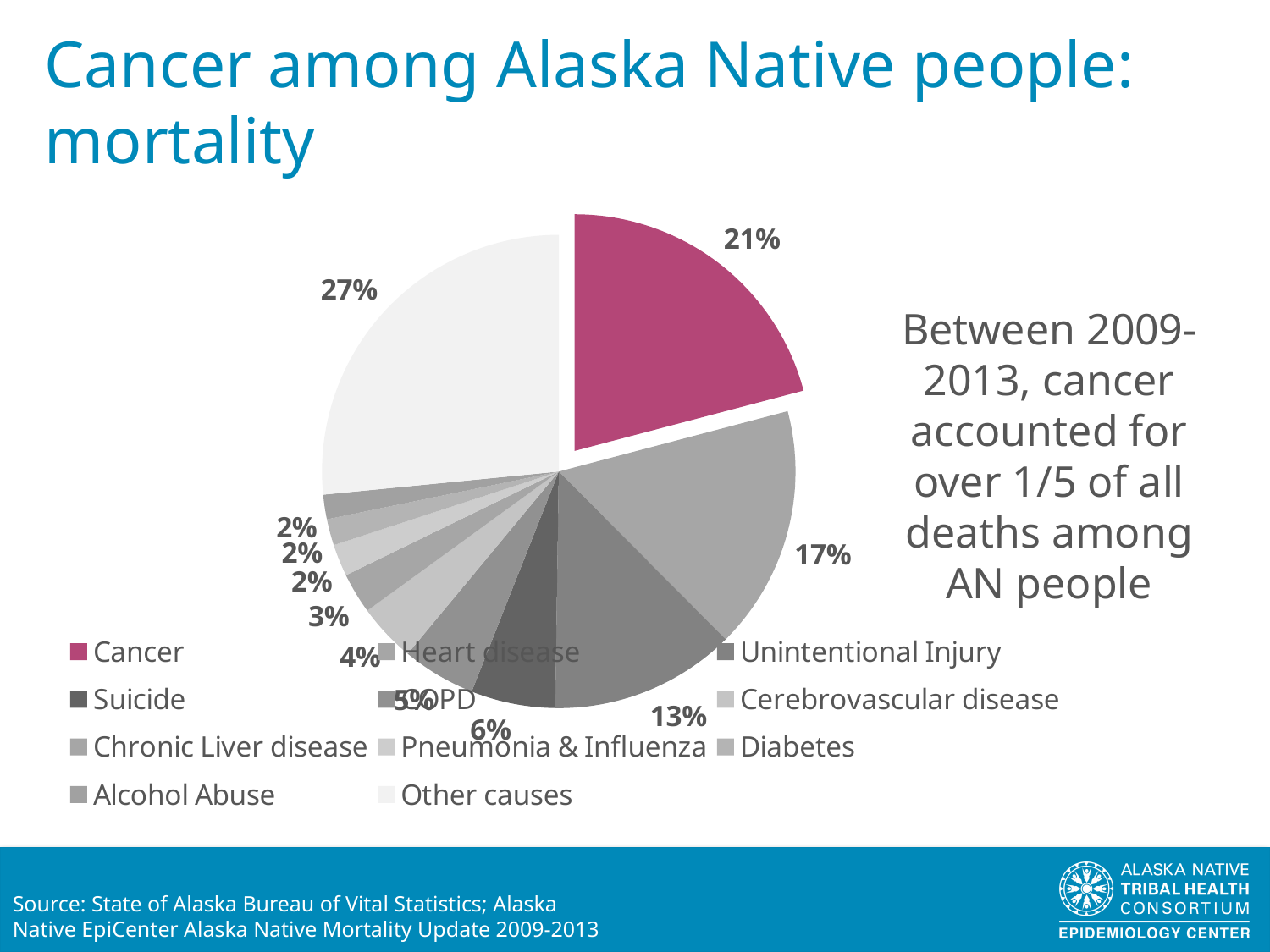
Which is larger, the Heart disease slice or the Unintentional Injury slice? Heart disease What percentage is shown for Heart disease? 17% What kind of chart is shown on the slide? pie chart How many categories does the legend list? 11 What is the difference in percentage points between Cancer and Heart disease? 4 percentage points Which category has the largest slice of the pie? Other causes What percentage is shown for Other causes? 27% What percentage is shown for Unintentional Injury? 13% What percentage of deaths does the Cancer slice represent? 21% What is the combined share of Cancer and Heart disease? 38% Which slice is pulled out (exploded) from the rest of the pie? Cancer Which is larger, the Cancer slice or the Other causes slice? Other causes